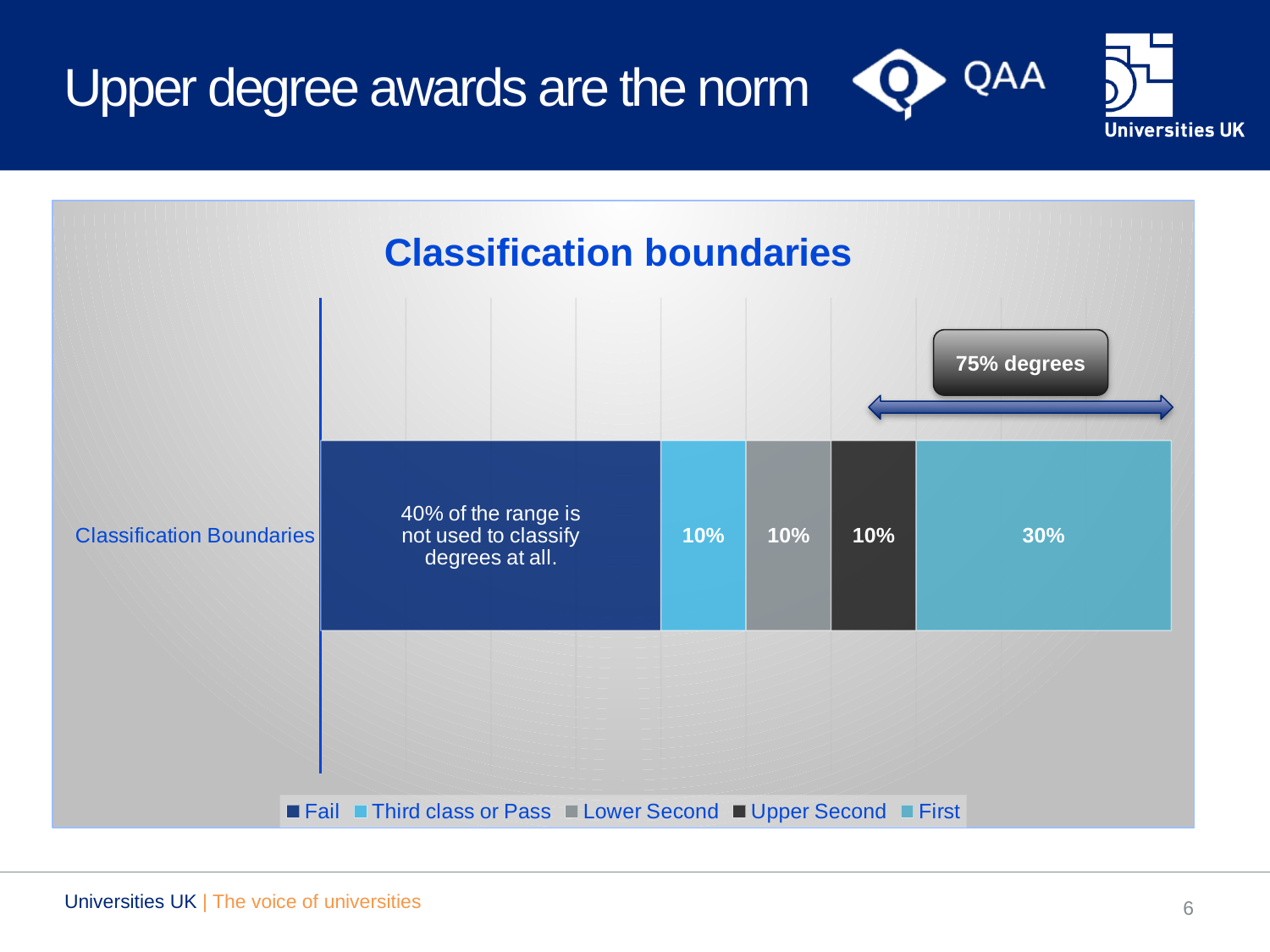
What kind of chart is shown on the slide? Stacked bar chart What is the value of the First segment in the Classification Boundaries bar? 30% Which is larger, the First segment or the Upper Second segment? First What is the difference between the First segment and the Lower Second segment? 20% What is the value of the Lower Second segment in the Classification Boundaries bar? 10% What is the value of the Upper Second segment in the Classification Boundaries bar? 10% What is the title of the chart? Classification boundaries What is the value of the Third class or Pass segment in the Classification Boundaries bar? 10% Which segment of the bar is the largest? Fail How many series does the chart legend list? 5 What share of the range does the Fail segment cover, according to its label? 40% What percentage of degrees does the annotation above the bar say fall in the Upper Second and First range? 75%